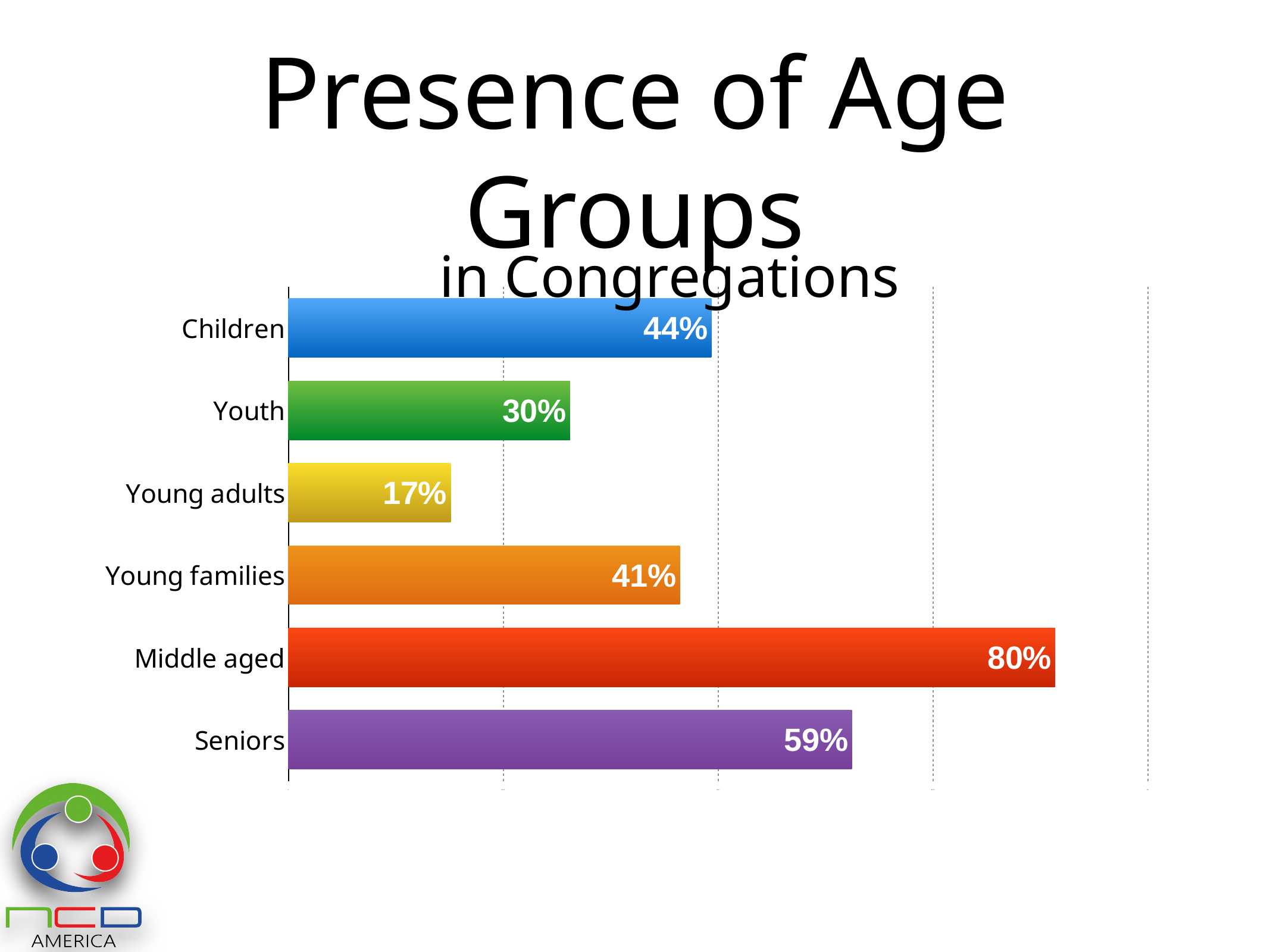
What is the difference between the values for Middle aged and Seniors? 21% How many age groups are shown in the chart? 6 What is the value for Youth? 30% What is the value for Children? 44% What is the value for Seniors? 59% What kind of chart is shown on the slide? Bar chart Which age group has the lowest value? Young adults What is the value for Young families? 41% Which is larger, the value for Children or the value for Young families? Children Which age group has the highest value? Middle aged What is the value for Young adults? 17% What is the title of the chart? Presence of Age Groups in Congregations